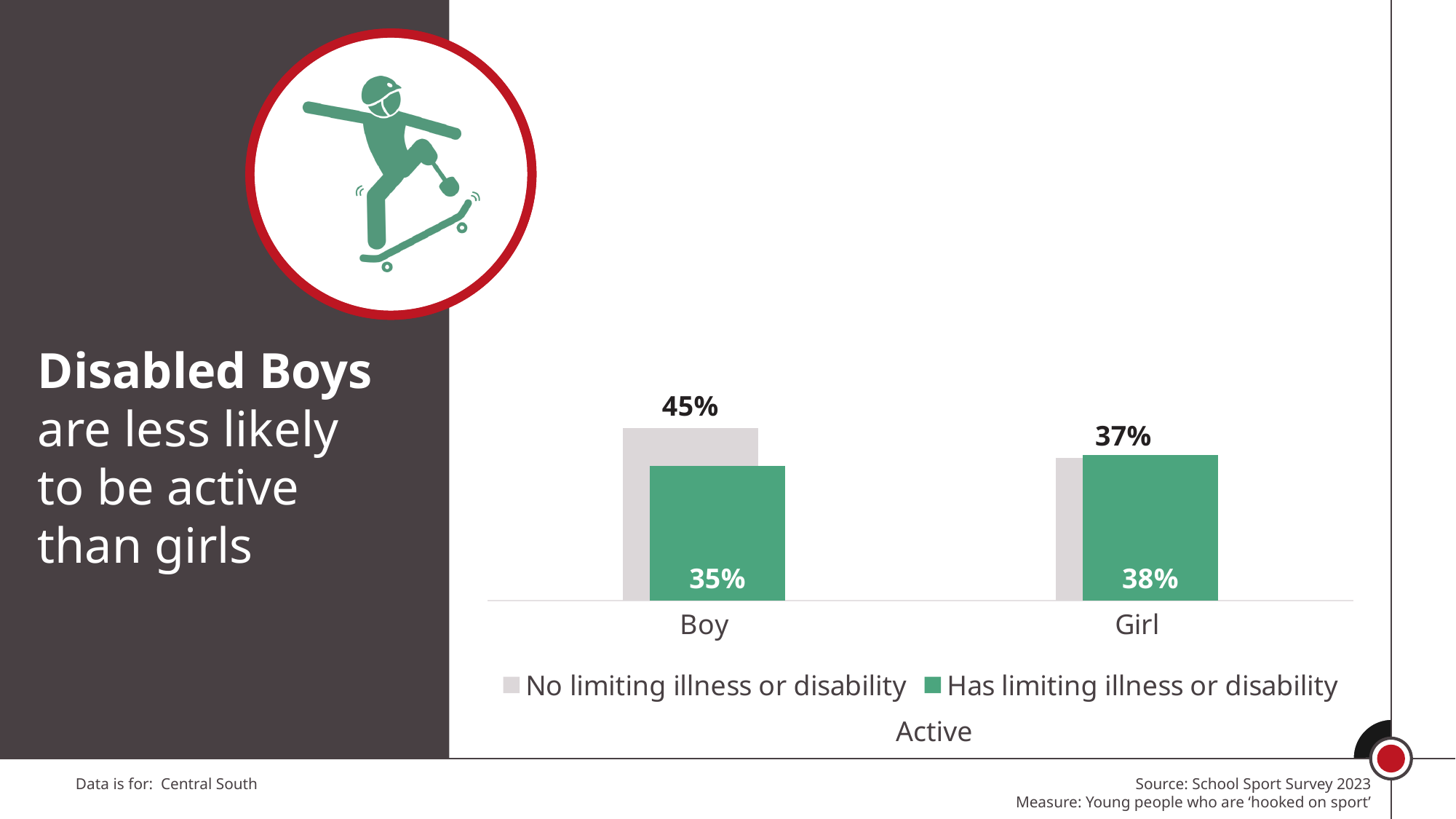
What kind of chart is shown on the slide? Bar chart Which bar on the chart has the highest value? Boy, No limiting illness or disability What is the value for Boy in the 'Has limiting illness or disability' series? 35% What is the value for Girl in the 'No limiting illness or disability' series? 37% Which category has the higher 'Has limiting illness or disability' value, Boy or Girl? Girl How many series does the legend list? 2 What is the difference between the 'No limiting illness or disability' and 'Has limiting illness or disability' values for Boy? 10% What is the value for Girl in the 'Has limiting illness or disability' series? 38% How many categories are shown on the x axis? 2 What is the difference between the 'No limiting illness or disability' values for Boy and Girl? 8% Which is larger for Boy: the 'No limiting illness or disability' value or the 'Has limiting illness or disability' value? No limiting illness or disability What is the value for Boy in the 'No limiting illness or disability' series? 45%